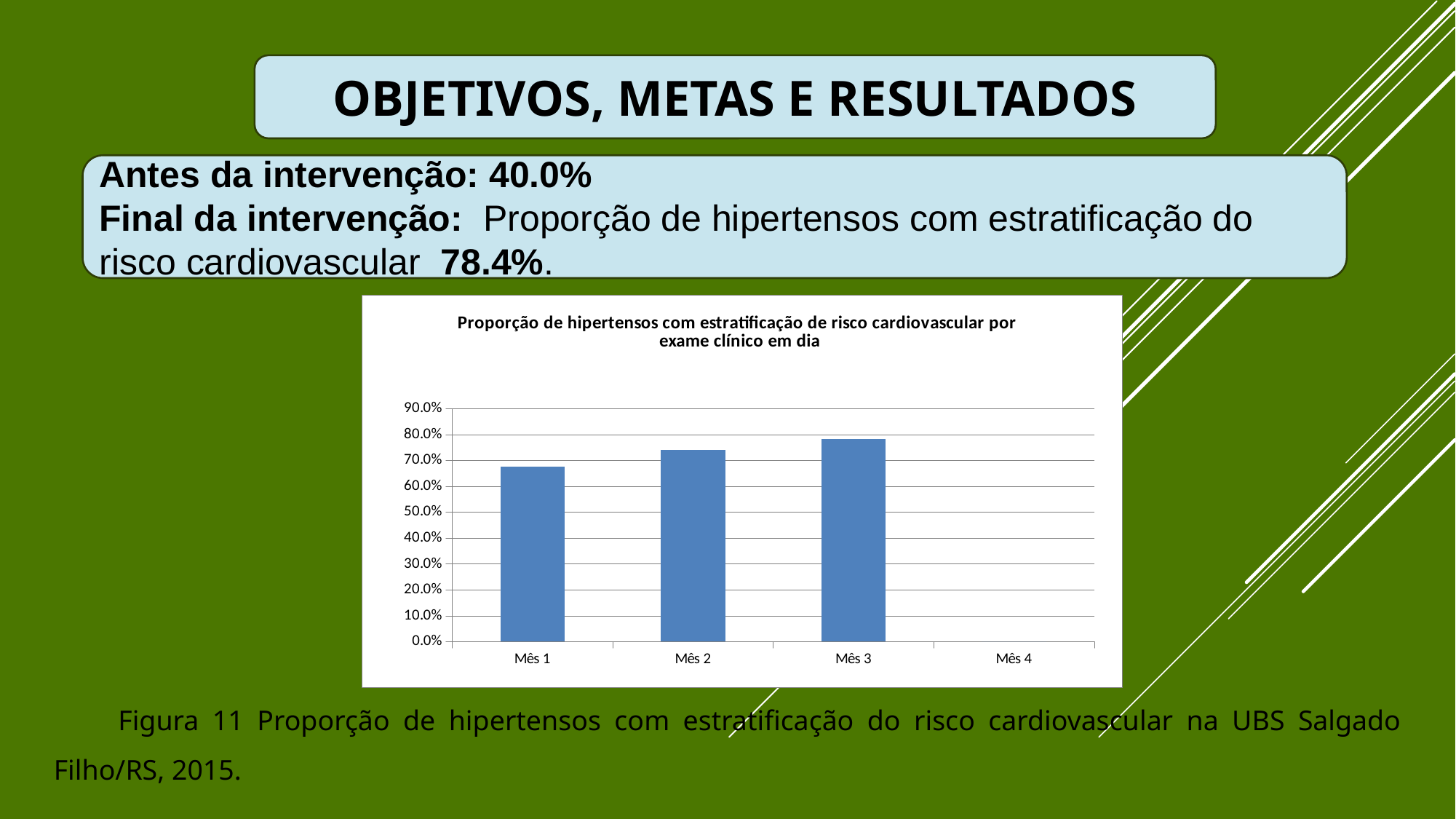
Do the values rise or fall from Mês 1 to Mês 3? rise Is the value for Mês 3 greater or less than 80.0%? less Is the value for Mês 1 greater or less than 70.0%? less Is the value for Mês 1 greater or less than 60.0%? greater Which month has the highest bar in the chart? Mês 3 Which month on the x axis has no bar plotted? Mês 4 What kind of chart is shown on the slide? bar chart What is the title of the chart? Proporção de hipertensos com estratificação de risco cardiovascular por exame clínico em dia Among the months with a bar plotted, which has the lowest value? Mês 1 How many categories are shown on the x axis of the chart? 4 Which is larger, the value for Mês 1 or the value for Mês 2? Mês 2